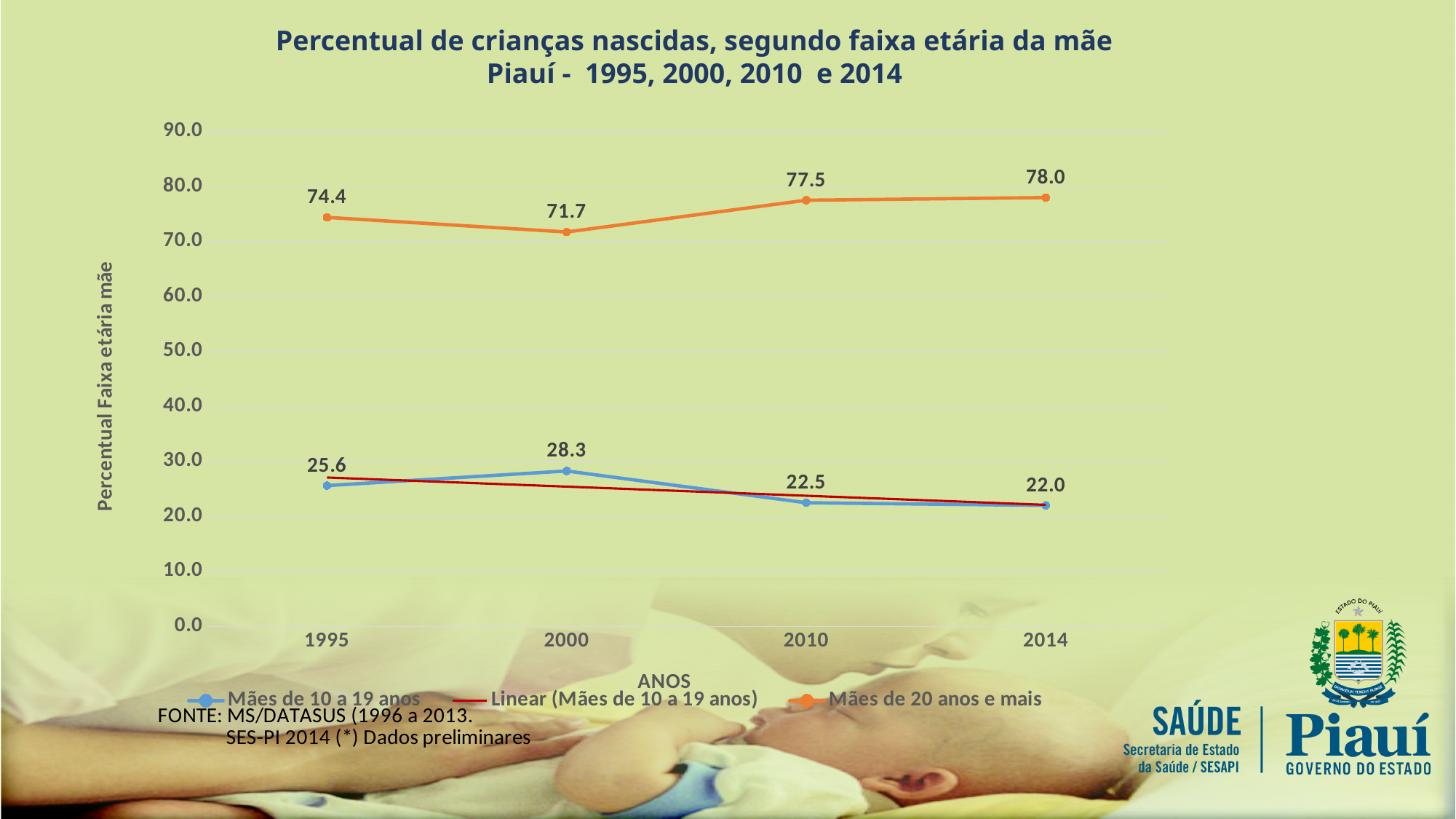
Which is larger: the 'Mães de 10 a 19 anos' value in 1995 or in 2014? 1995 In which year is the value for 'Mães de 10 a 19 anos' highest? 2000 What is the value for 'Mães de 10 a 19 anos' in 2000? 28.3 What is the value for 'Mães de 20 anos e mais' in 1995? 74.4 In which year is the value for 'Mães de 20 anos e mais' lowest? 2000 How many years are shown on the x axis? 4 What kind of chart is shown on the slide? Line chart What is the value for 'Mães de 20 anos e mais' in 2014? 78.0 Does the 'Mães de 10 a 19 anos' series rise or fall from 2000 to 2014? Fall How many entries does the legend list? 3 What is the difference between the 'Mães de 20 anos e mais' values in 2014 and 2000? 6.3 What is the value for 'Mães de 10 a 19 anos' in 2010? 22.5